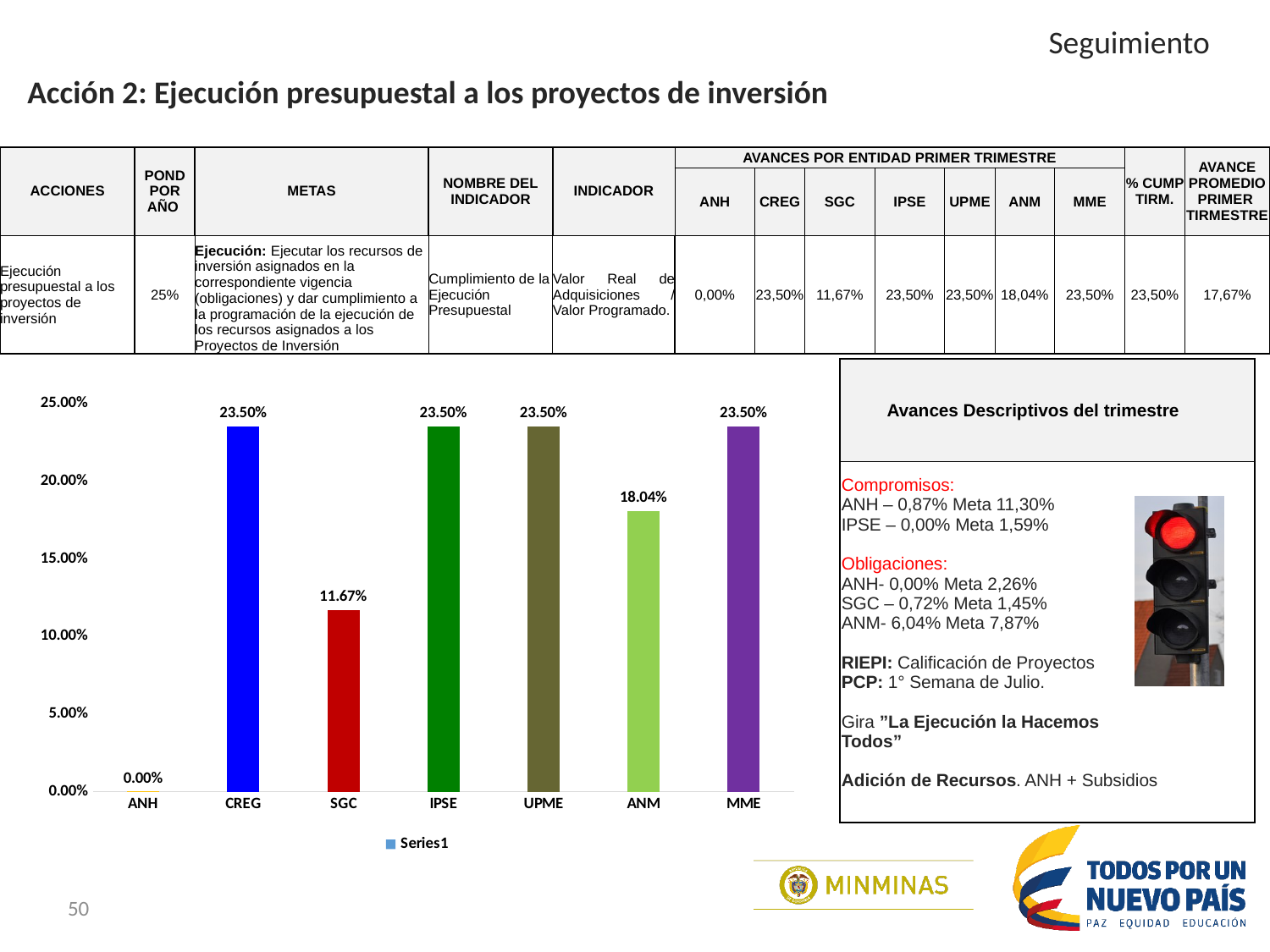
Which category has the lowest value in the bar chart? ANH How many categories are shown on the x axis of the bar chart? 7 What is the difference between the values for ANM and SGC in the bar chart? 6.37% What is the value for CREG in the bar chart? 23.50% What is the value for SGC in the bar chart? 11.67% Which is larger in the bar chart, the value for ANM or the value for SGC? ANM What is the value for ANM in the bar chart? 18.04% What is the value for ANH in the bar chart? 0.00% Is the value for ANM in the bar chart greater or less than 15.00%? greater What kind of chart is shown on the slide? Bar chart How many series does the legend of the bar chart list? 1 What is the difference between the values for CREG and SGC in the bar chart? 11.83%